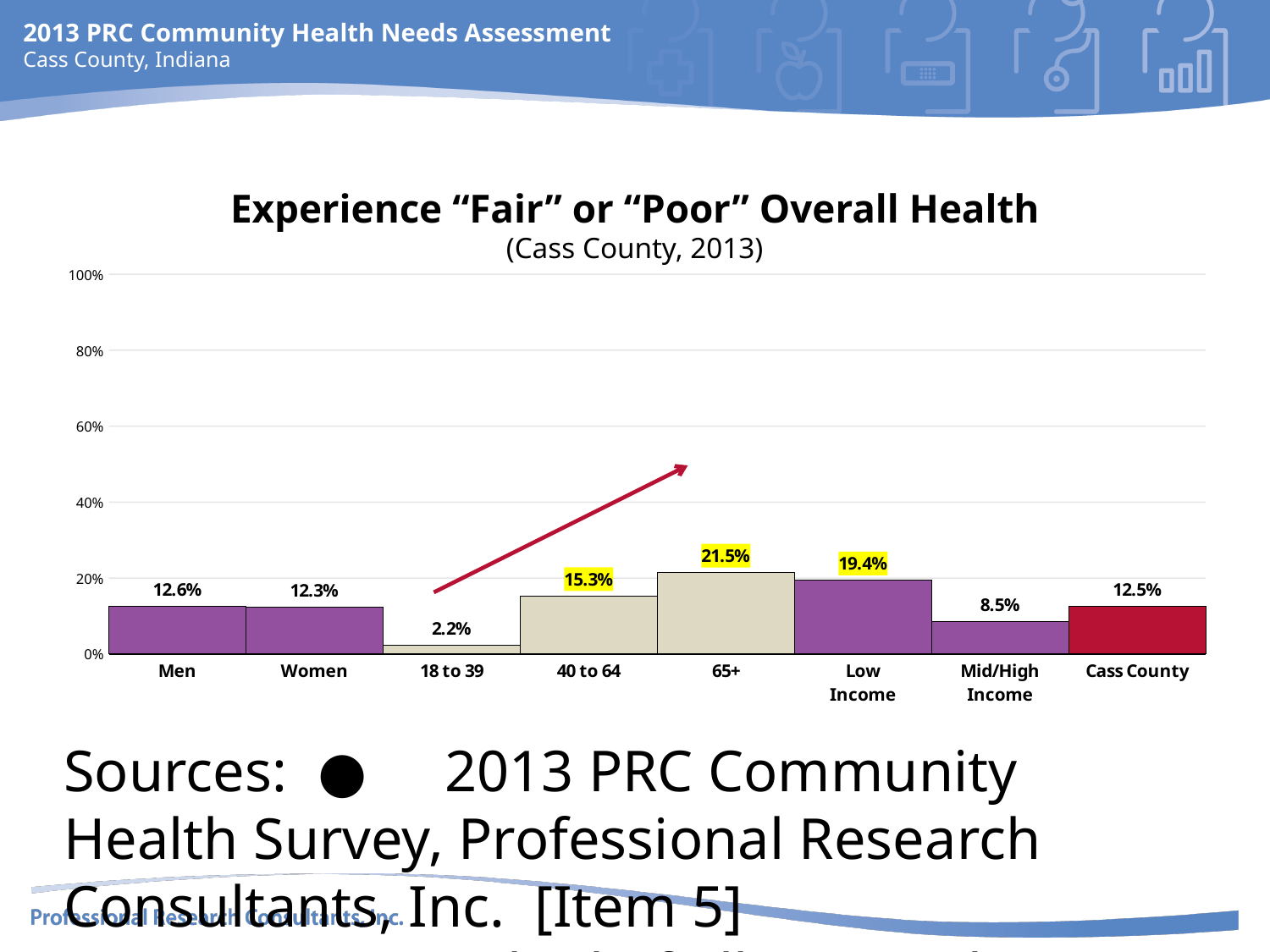
What is the title of the chart? Experience "Fair" or "Poor" Overall Health What is the value for Cass County overall? 12.5% What is the value for Mid/High Income? 8.5% What is the value for Men? 12.6% Which category has the highest value? 65+ Which is larger, the value for 40 to 64 or the value for 65+? 65+ What is the value for the 65+ age group? 21.5% What kind of chart is this? bar chart How many categories are shown on the x axis? 8 What is the difference between the Low Income and Mid/High Income values? 10.9% Is the value for Low Income greater or less than 40%? less Which category has the lowest value? 18 to 39